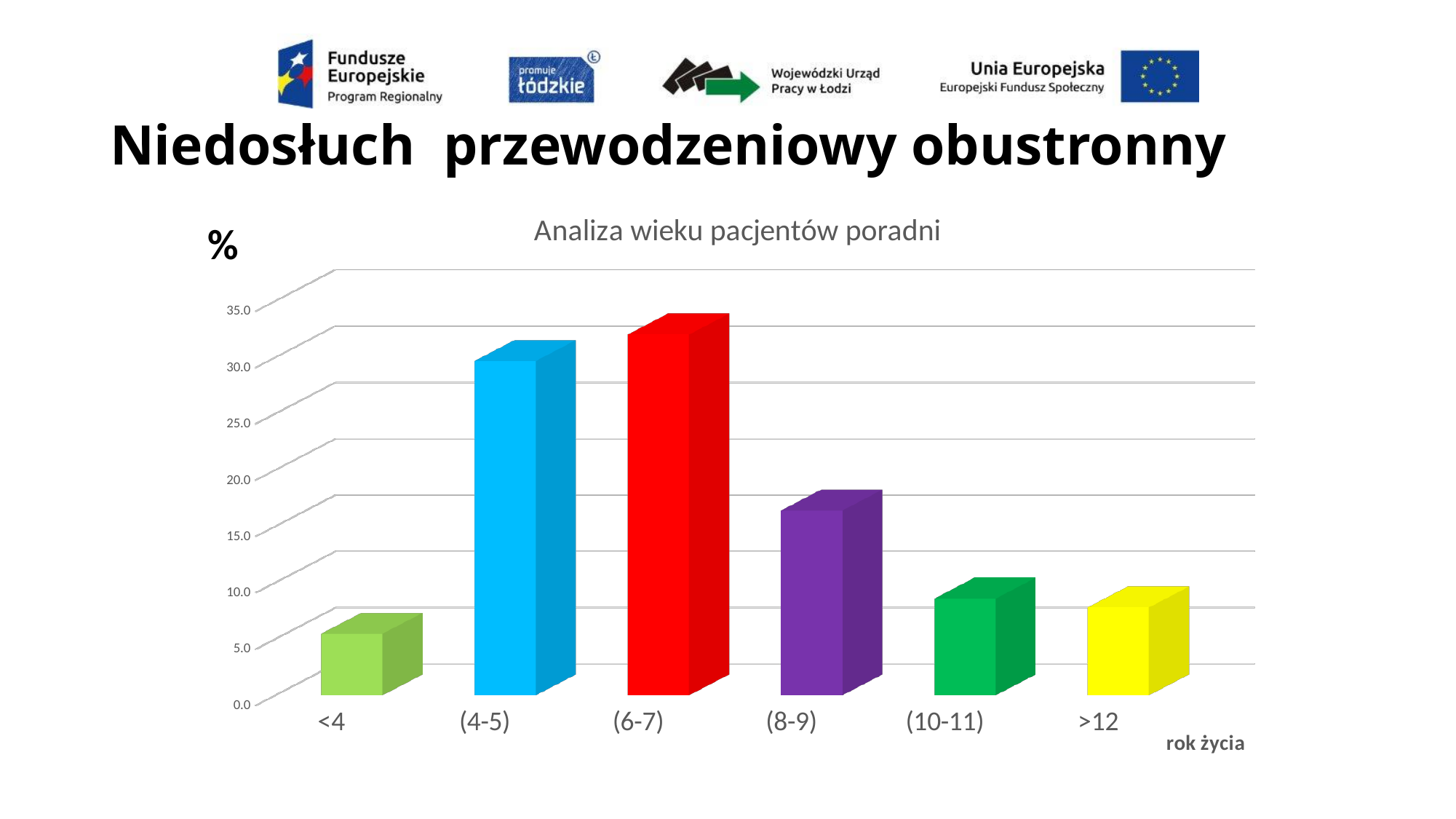
What type of chart is shown on the slide? bar chart Which age category has the highest value in the chart? (6-7) Is the value for (6-7) greater or less than 25? greater Is the value for (10-11) greater or less than 15? less Is the value for <4 greater or less than 10? less Which has a larger value, (4-5) or (8-9)? (4-5) Which age category has the lowest value in the chart? <4 Do the values rise or fall from (6-7) to >12 along the x axis? fall How many age categories are shown on the x axis of the chart? 6 What is the title of the chart? Analiza wieku pacjentów poradni